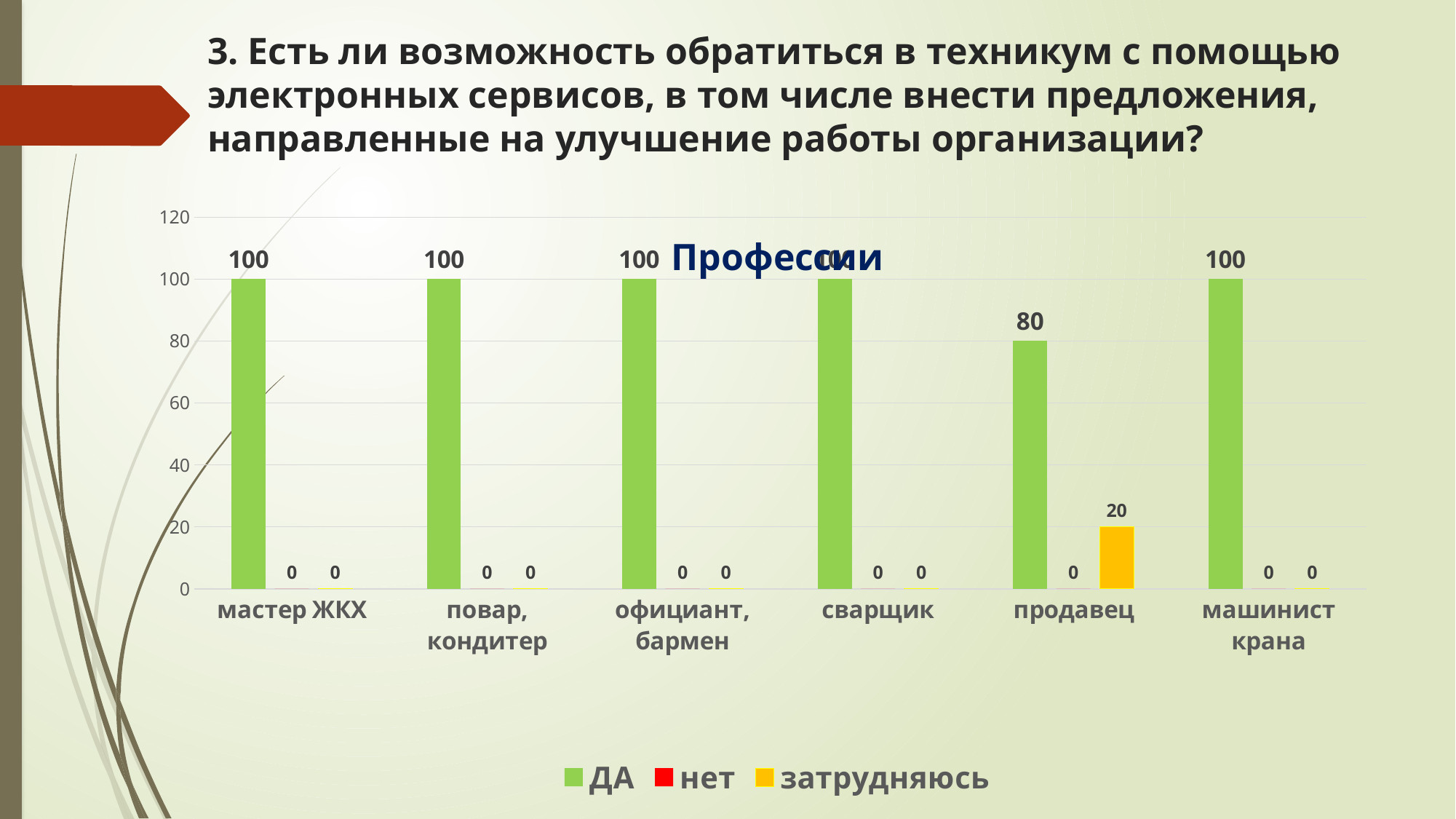
What is the value of the нет series for мастер ЖКХ? 0 Which category has the lowest value in the ДА series? продавец What is the value of the затрудняюсь series for продавец? 20 How many series does the legend list? 3 What is the value of the ДА series for сварщик? 100 What kind of chart is shown on the slide? bar chart What is the difference between the ДА value for машинист крана and the ДА value for продавец? 20 What is the title of the chart? Профессии Which is larger for продавец: the ДА value or the затрудняюсь value? ДА How many categories are shown on the x axis? 6 Which category has the highest value in the затрудняюсь series? продавец What is the value of the ДА series for продавец? 80